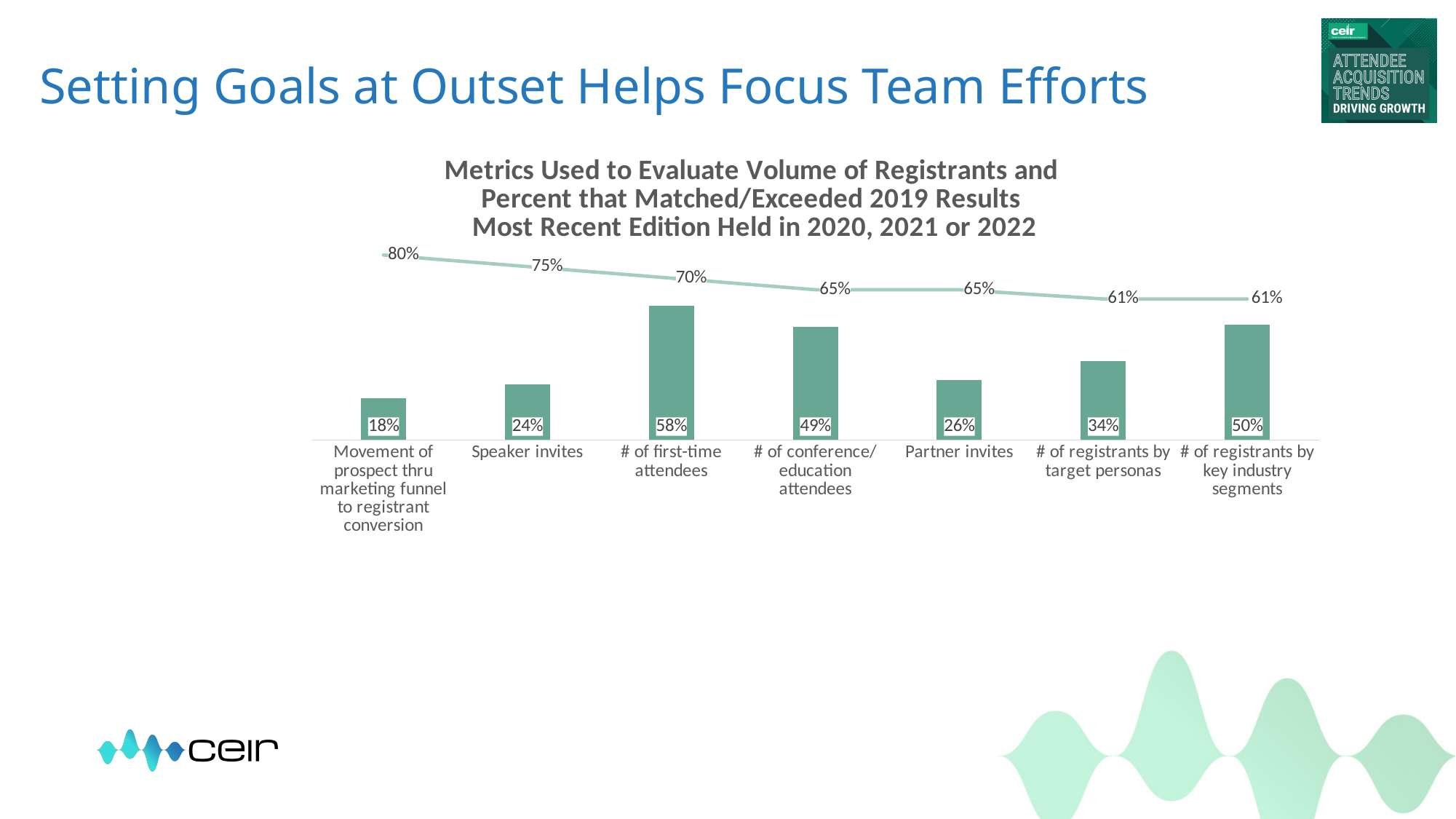
Which category has the lowest bar value? Movement of prospect thru marketing funnel to registrant conversion Does the line series rise or fall from left to right across the categories? Fall What is the difference between the line values for Speaker invites and # of registrants by key industry segments? 14% What kind of chart is this? Bar chart with a line What is the line value shown above the Partner invites bar? 65% Which has a larger bar value, Partner invites or # of registrants by target personas? # of registrants by target personas What is the difference between the bar values for # of first-time attendees and # of conference/education attendees? 9% What is the bar value for Speaker invites? 24% How many categories are shown on the x axis? 7 What is the line value shown above the Movement of prospect thru marketing funnel to registrant conversion bar? 80% What is the bar value for # of first-time attendees? 58% Which category has the highest bar value? # of first-time attendees